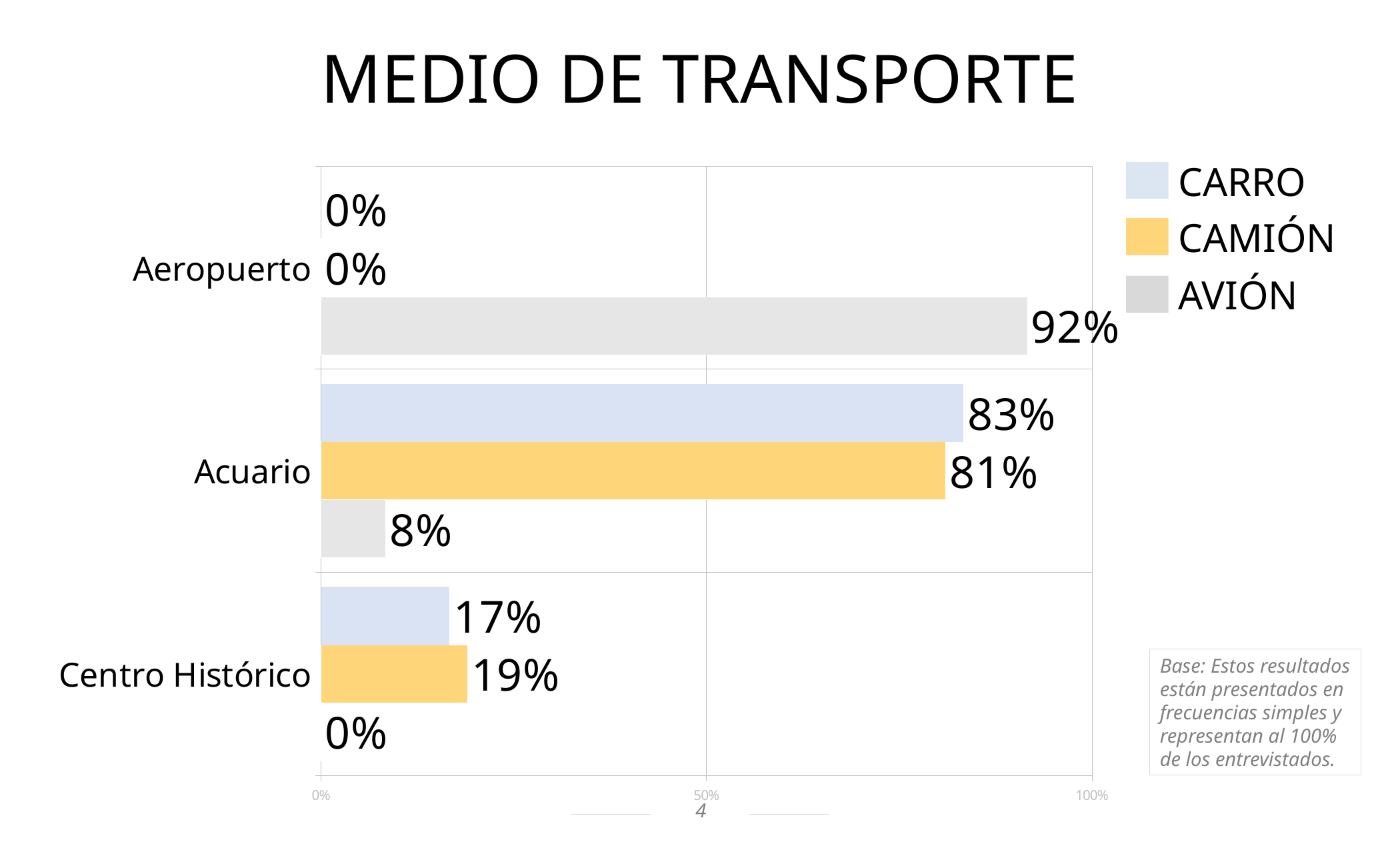
What is the value for CARRO at Acuario? 83% What is the difference between the CARRO and CAMIÓN values at Centro Histórico? 2% What is the value for CAMIÓN at Centro Histórico? 19% How many series does the legend list? 3 What is the value for AVIÓN at Aeropuerto? 92% What is the value for AVIÓN at Acuario? 8% What is the title of the chart? MEDIO DE TRANSPORTE Which category has the lowest value for CAMIÓN? Aeropuerto What kind of chart is shown on the slide? Bar chart At Acuario, which is larger: the CARRO value or the AVIÓN value? CARRO How many categories are shown on the y axis? 3 Which category has the highest value for AVIÓN? Aeropuerto